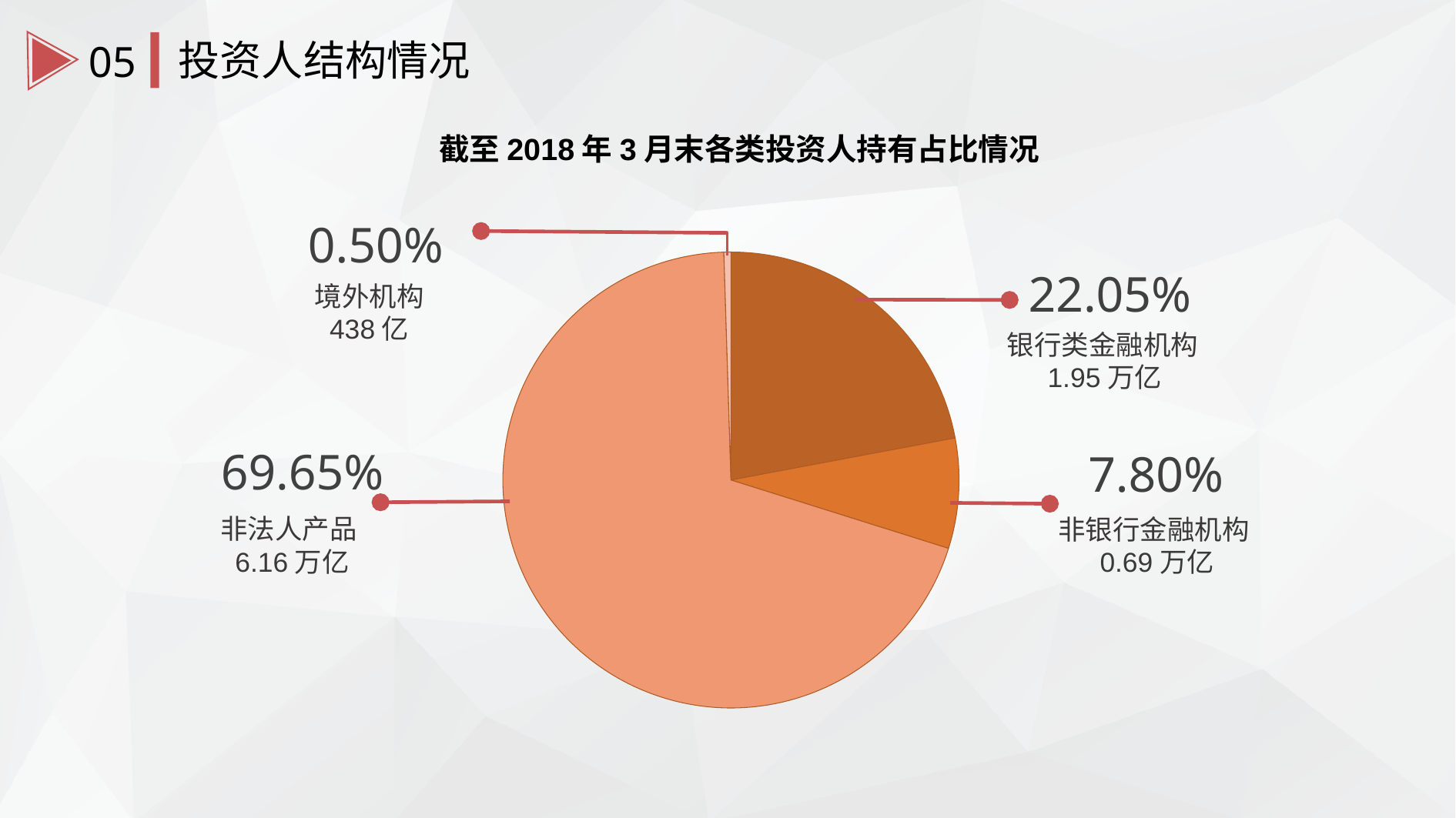
What share of the pie does 境外机构 hold? 0.50% What holding amount is shown for 境外机构? 438 亿 What is the difference in percentage points between the shares of 银行类金融机构 and 非银行金融机构? 14.25 What is the title of the chart? 截至 2018 年 3 月末各类投资人持有占比情况 Which category has the largest share of the pie? 非法人产品 Which category has the smallest share of the pie? 境外机构 What kind of chart is shown on the slide? pie chart What share of the pie does 银行类金融机构 hold? 22.05% How many categories are shown in the pie chart? 4 What share of the pie does 非法人产品 hold? 69.65% What holding amount is shown for 银行类金融机构? 1.95 万亿